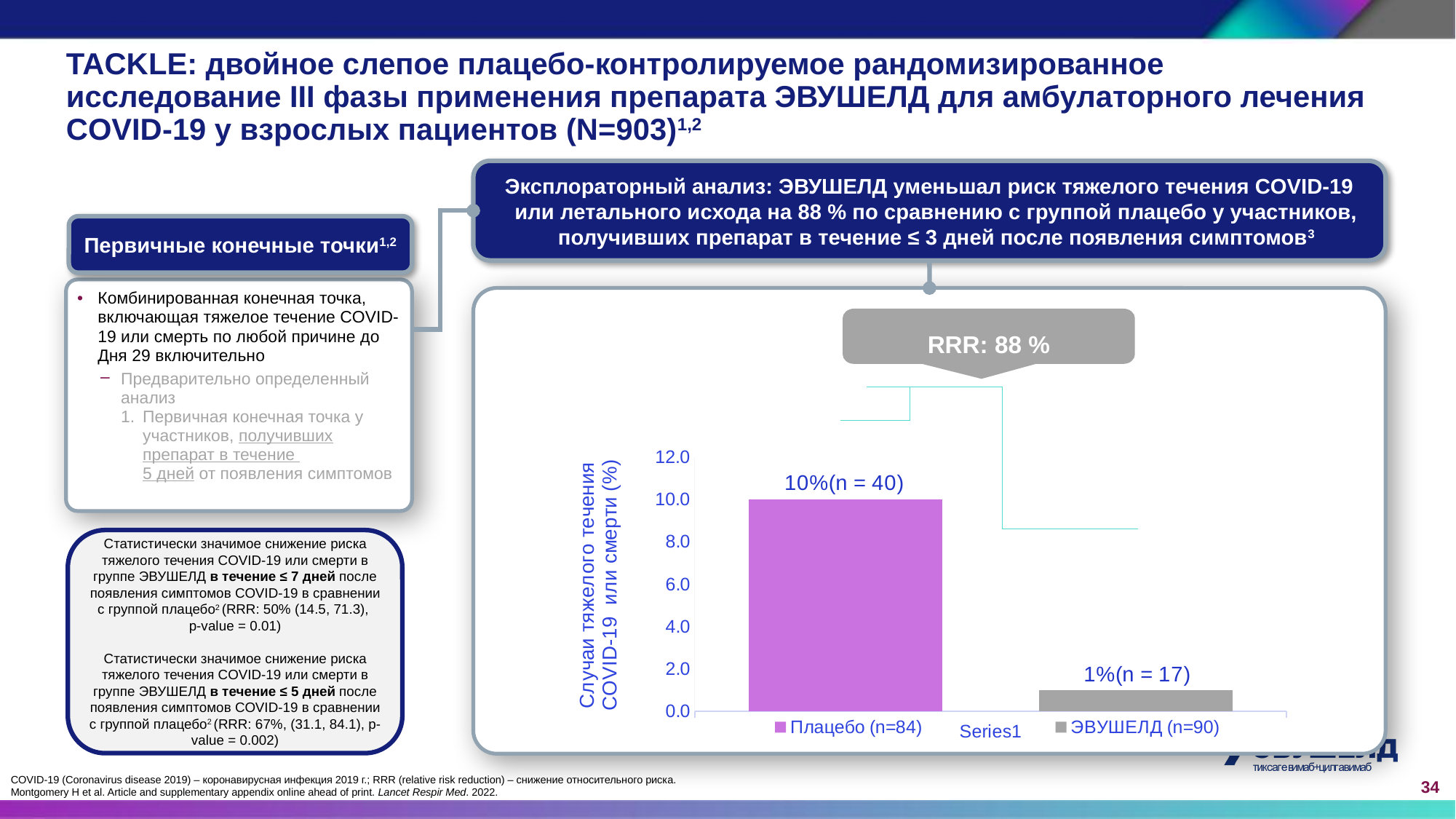
Is the value for Плацебо (n=84) greater or less than 8.0? greater What type of chart is shown on the slide? bar chart Is the value for ЭВУШЕЛД (n=90) greater or less than 2.0? less What is the data label on the bar for ЭВУШЕЛД (n=90)? 1%(n = 17) What is the maximum value shown on the chart's vertical axis? 12.0 Which series has the higher bar, Плацебо (n=84) or ЭВУШЕЛД (n=90)? Плацебо (n=84) How many series does the chart legend list? 2 What is the data label on the bar for Плацебо (n=84)? 10%(n = 40) How many bars are plotted in the chart? 2 What RRR value is shown in the callout above the chart? RRR: 88 % Which series has the lowest bar in the chart? ЭВУШЕЛД (n=90) Which series has the highest bar in the chart? Плацебо (n=84)